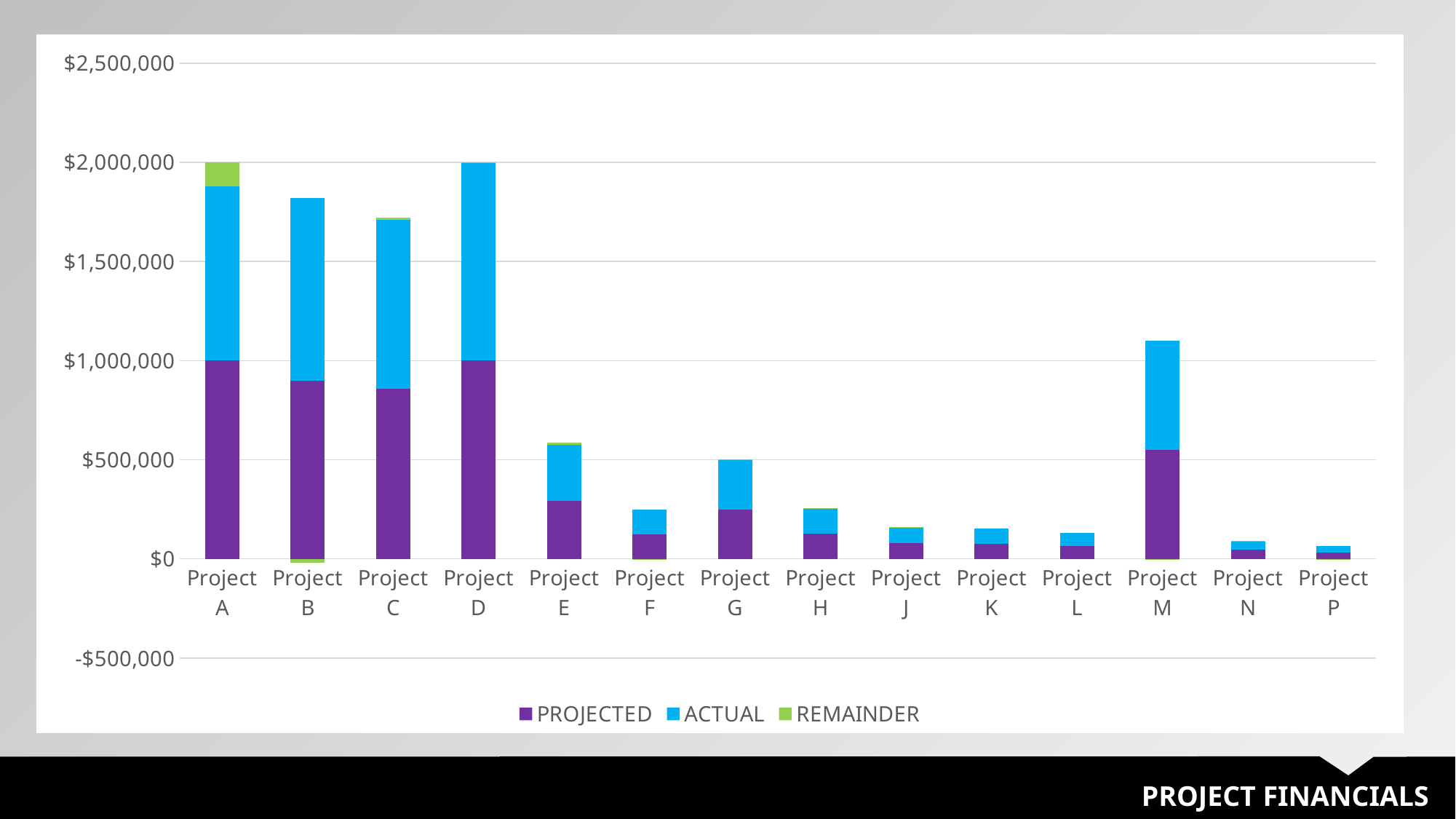
What is the title shown at the bottom of the slide? PROJECT FINANCIALS What kind of chart is shown on the slide? Stacked bar chart Which has the larger total bar, Project B or Project C? Project B Is the total bar for Project B greater or less than $1,500,000? greater Which project has the lowest total bar? Project P Is the total bar for Project F greater or less than $500,000? less Is the PROJECTED value for Project C greater or less than $1,000,000? less How many projects are shown on the x axis of the chart? 14 Which has the larger total bar, Project G or Project M? Project M Which colour represents the ACTUAL series in the chart? Blue How many series does the chart's legend list? 3